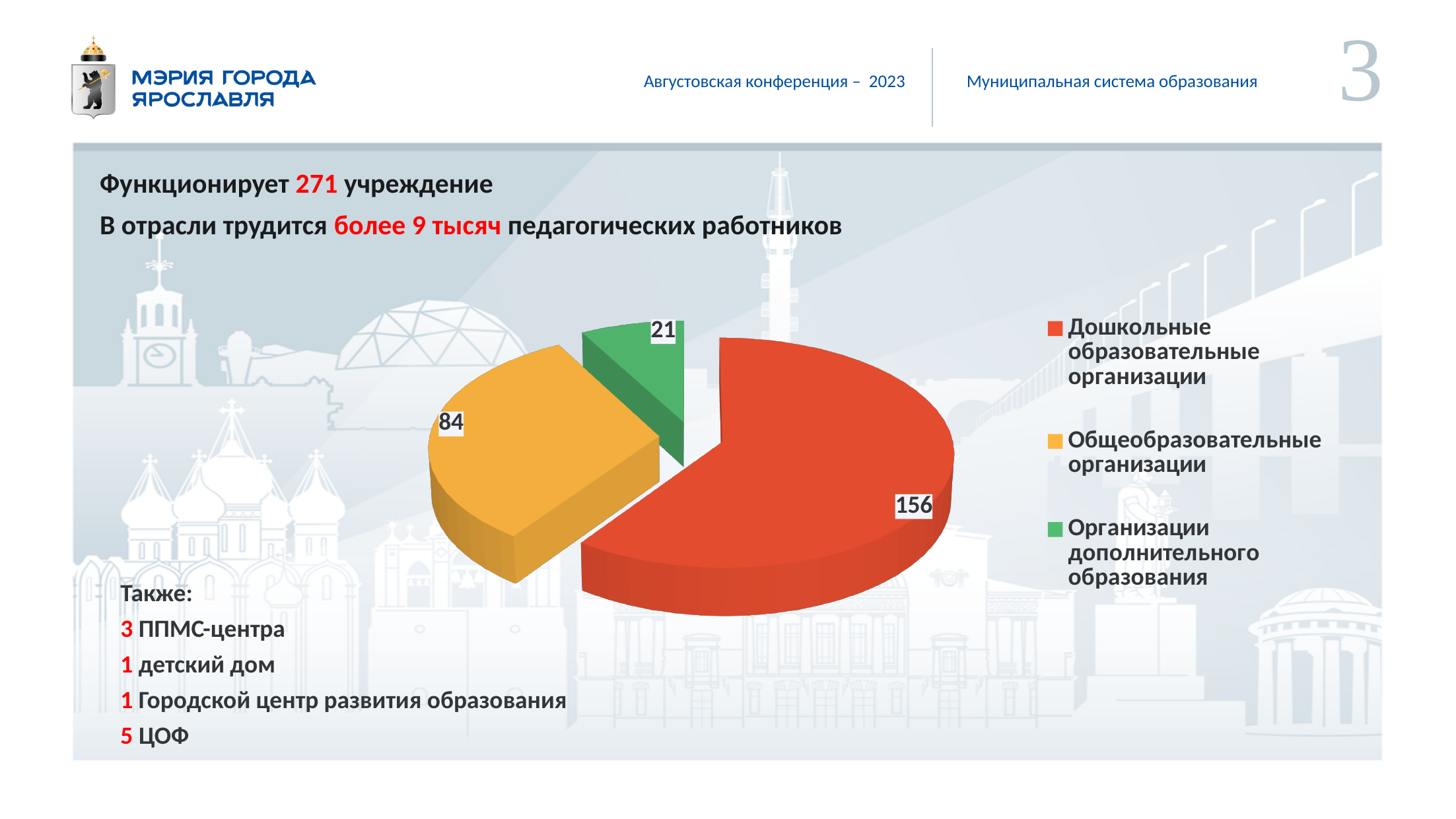
What is the total of the three values shown in the pie chart? 261 Which category has the largest slice in the pie chart? Дошкольные образовательные организации How many slices does the pie chart have? 3 What is the value for Организации дополнительного образования in the pie chart? 21 What colour is the slice for Организации дополнительного образования in the pie chart? green What kind of chart is shown on the slide? pie chart What is the difference between the values for Дошкольные образовательные организации and Общеобразовательные организации? 72 Which is larger: the value for Общеобразовательные организации or the value for Организации дополнительного образования? Общеобразовательные организации How many entries does the legend of the pie chart list? 3 What is the value for Общеобразовательные организации in the pie chart? 84 What is the value for Дошкольные образовательные организации in the pie chart? 156 Which category has the smallest slice in the pie chart? Организации дополнительного образования